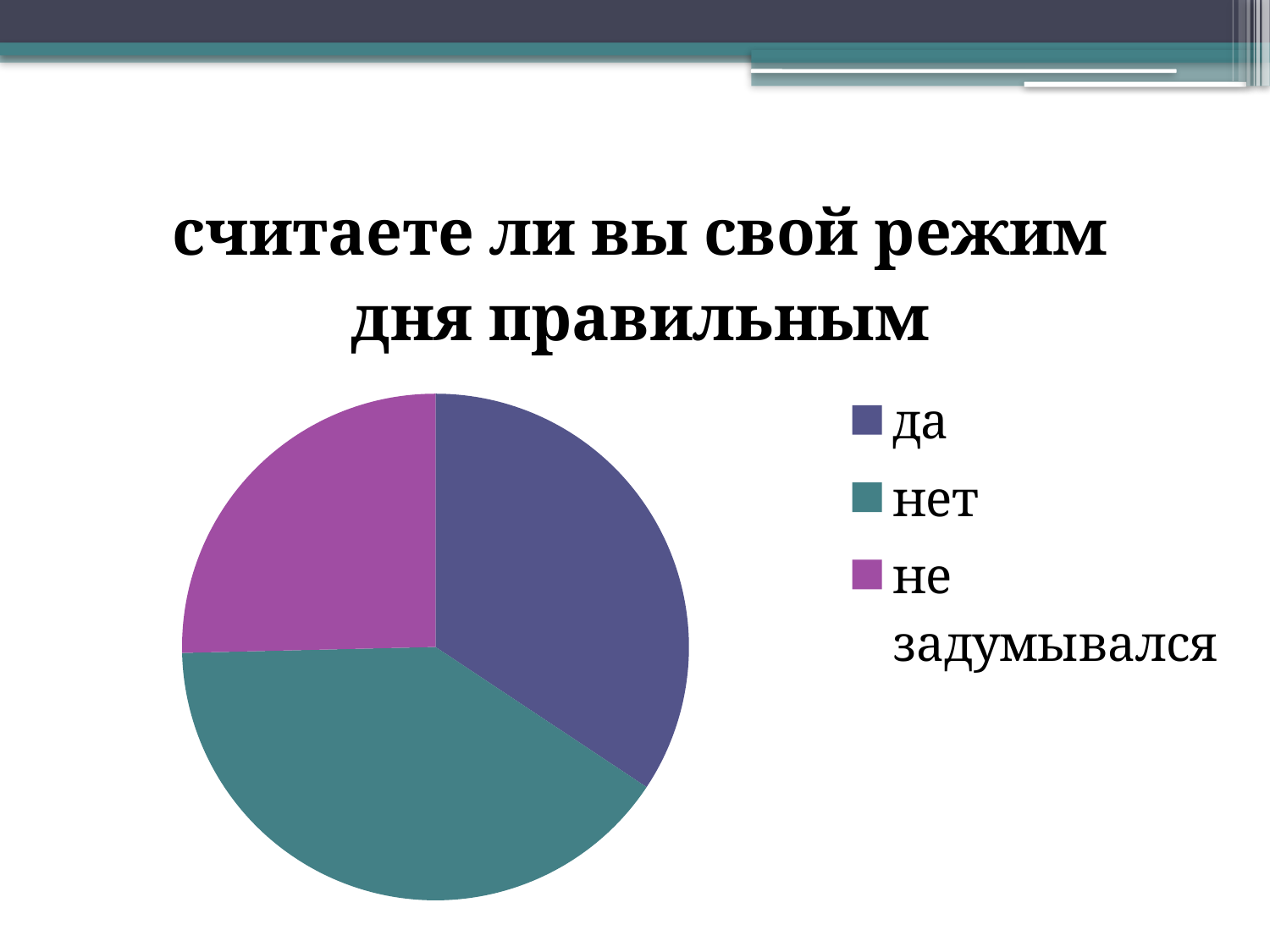
How many entries does the legend list? 3 Which category has the smallest slice of the pie? не задумывался What colour is the "нет" slice? teal Which category has the largest slice of the pie? нет Which slice is larger, "да" or "не задумывался"? да How many slices does the pie chart have? 3 What is the title of the chart? считаете ли вы свой режим дня правильным Which slice is larger, "нет" or "не задумывался"? нет What kind of chart is shown on the slide? pie chart